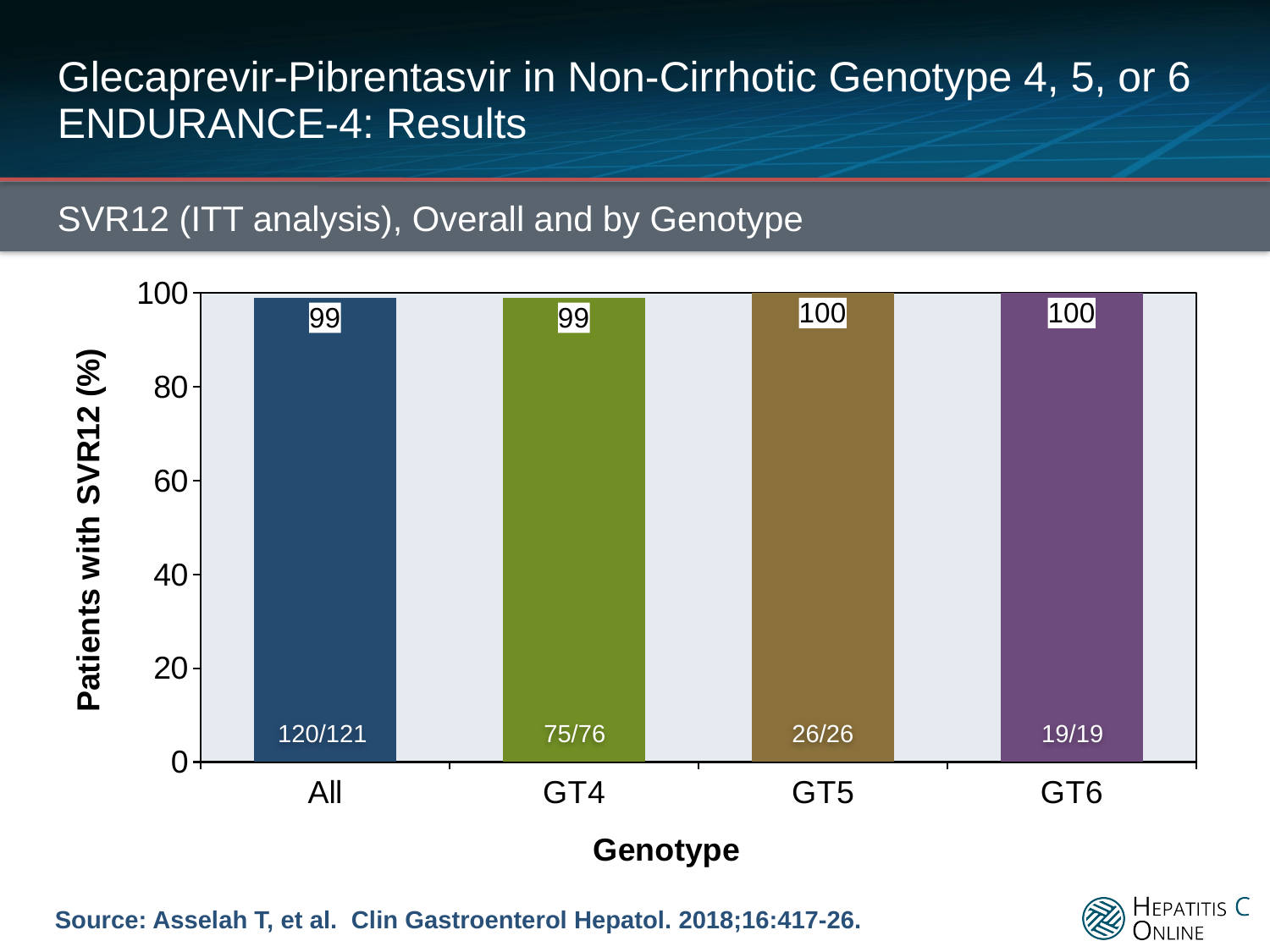
Is the SVR12 value for GT4 greater or less than 80? greater What is the difference between the SVR12 rate for GT5 and the SVR12 rate for GT4? 1 What fraction of patients is shown inside the All bar? 120/121 What kind of chart is shown on the slide? Bar chart What fraction of patients is shown inside the GT4 bar? 75/76 How many genotype categories are shown on the x axis? 4 What is the label of the y axis? Patients with SVR12 (%) What is the SVR12 rate for GT4? 99 What is the SVR12 rate for GT6? 100 What is the SVR12 rate for GT5? 100 What fraction of patients is shown inside the GT6 bar? 19/19 What is the SVR12 rate for the All group? 99